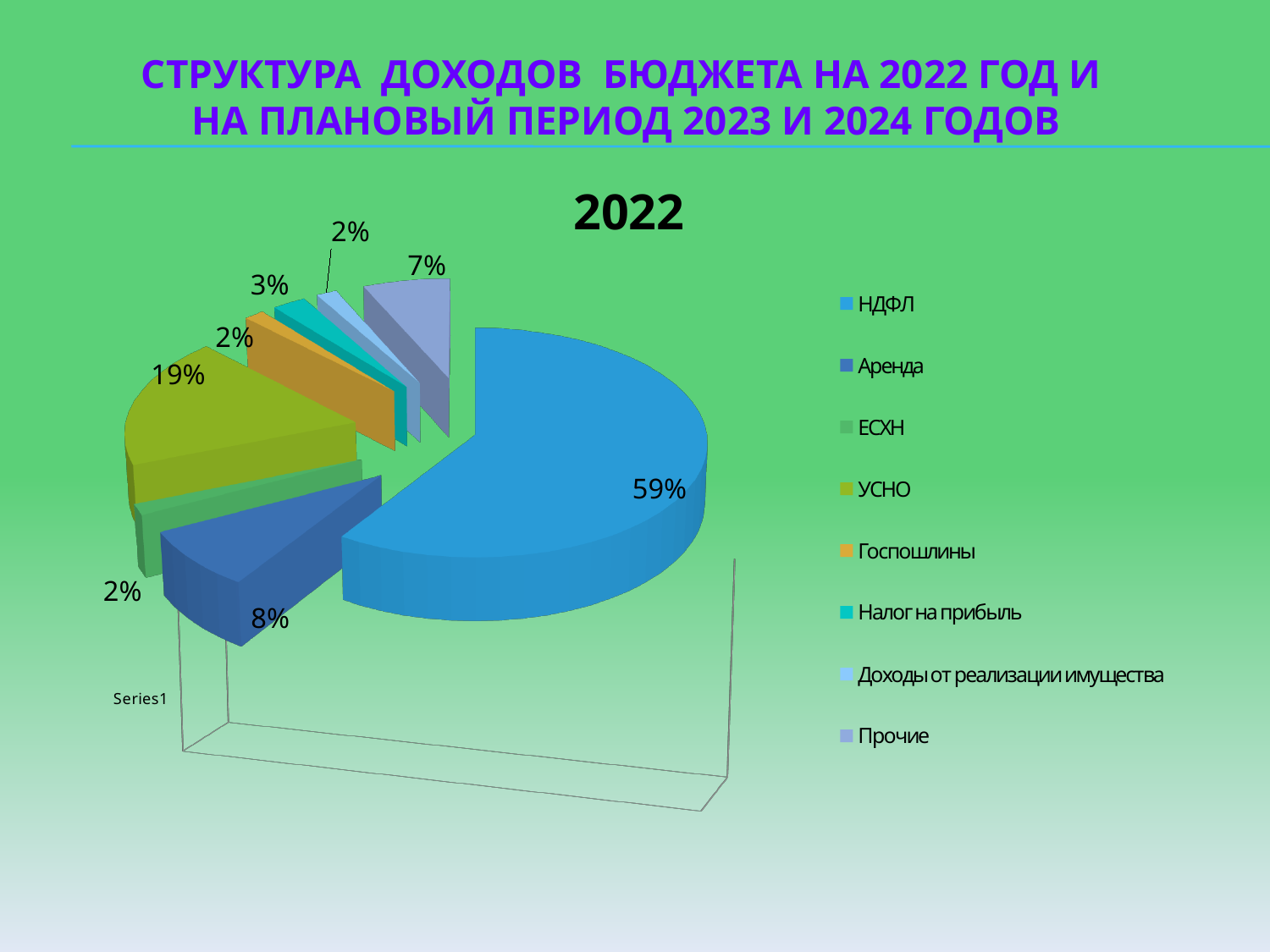
What share of the pie does Прочие have? 7% What share of the pie does НДФЛ have? 59% How many entries does the legend list? 8 How many slices does the pie chart have? 8 What is the difference between the shares of НДФЛ and УСНО? 40% What share of the pie does Аренда have? 8% What is the title shown above the pie chart? 2022 Which is larger, the share of Аренда or the share of Прочие? Аренда Which category has the largest share of the pie? НДФЛ What kind of chart is shown on the slide? pie chart